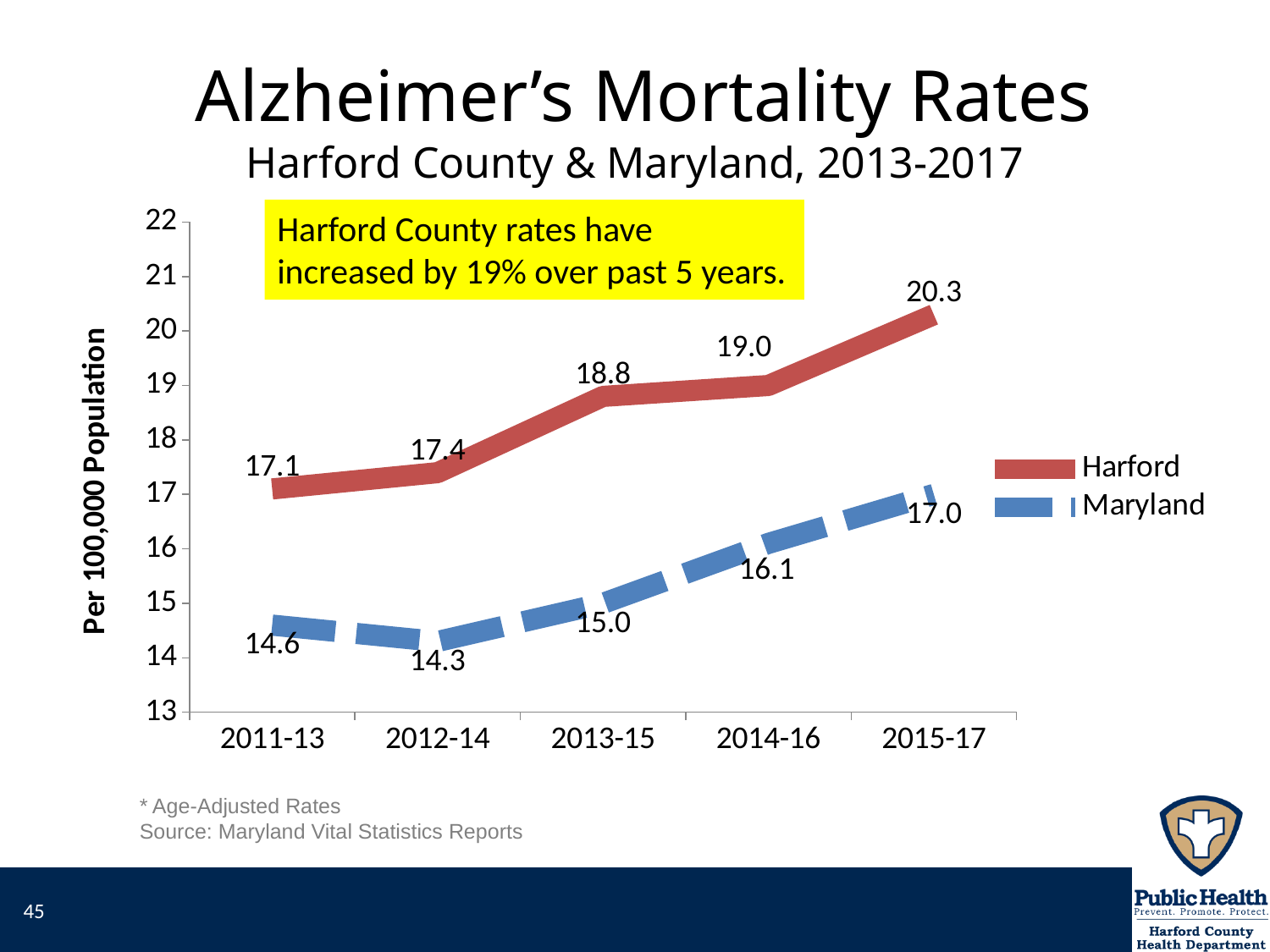
How many series does the legend list? 2 How many time periods are shown on the x axis? 5 Which is larger in 2014-16, the Harford rate or the Maryland rate? Harford In which period is the Harford rate highest? 2015-17 What is the Harford Alzheimer's mortality rate for 2015-17? 20.3 What kind of chart is shown on the slide? Line chart What is the Harford rate for 2013-15? 18.8 By how much did the Harford rate change from 2011-13 to 2015-17? 3.2 Does the Harford rate rise or fall from 2011-13 to 2015-17? Rise In which period is the Maryland rate lowest? 2012-14 What is the difference between the Harford and Maryland rates in 2015-17? 3.3 What is the Maryland Alzheimer's mortality rate for 2012-14? 14.3